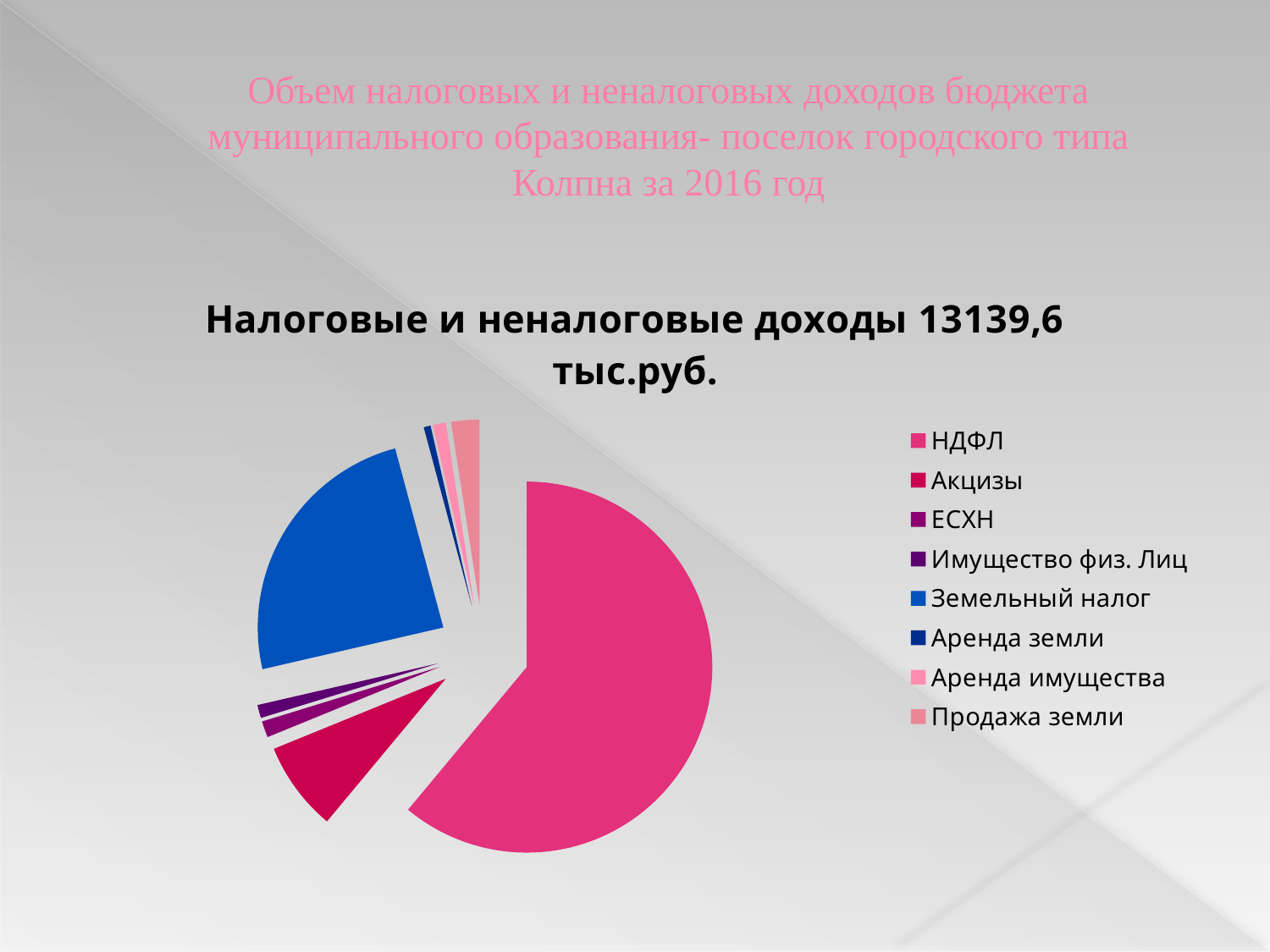
Which is larger in the pie chart, Акцизы or Земельный налог? Земельный налог How many categories does the legend of the pie chart list? 8 Which category has the largest slice of the pie chart? НДФЛ Which is larger in the pie chart, Продажа земли or Земельный налог? Земельный налог What kind of chart is shown on the slide? pie chart What total amount is stated in the chart title? 13139,6 тыс.руб. What is the title of the pie chart? Налоговые и неналоговые доходы 13139,6 тыс.руб. Which is larger in the pie chart, Акцизы or Имущество физ. Лиц? Акцизы Which category has the second-largest slice of the pie chart? Земельный налог